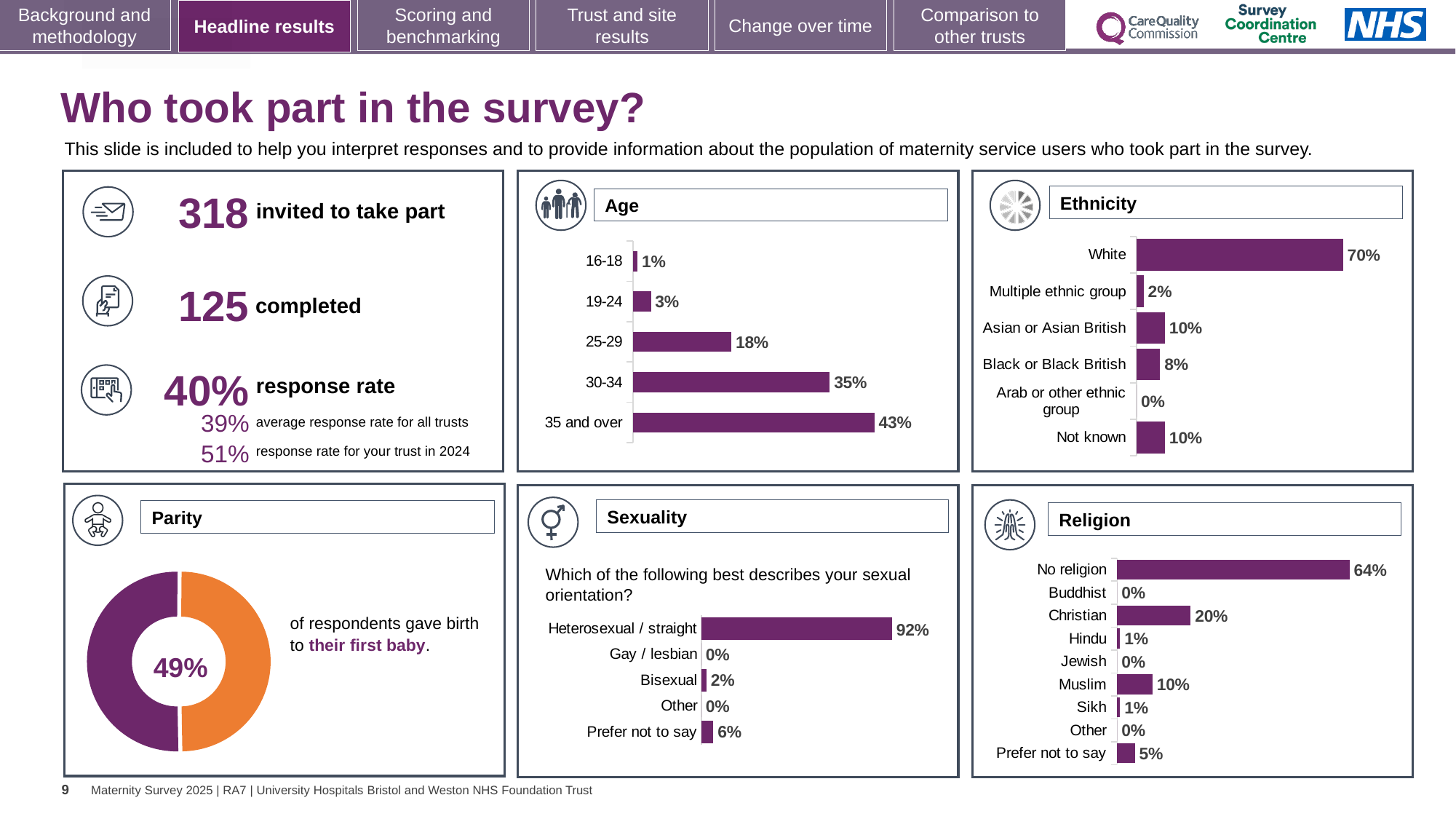
In the Age chart, which age group has the lowest percentage? 16-18 In the Age chart, what percentage of respondents were aged 35 and over? 43% In the Age chart, what is the difference between the 30-34 and 25-29 percentages? 17% In the Religion chart, what percentage of respondents were Christian? 20% In the Ethnicity chart, which is larger: Asian or Asian British or Black or Black British? Asian or Asian British In the Sexuality chart, which category has the highest percentage? Heterosexual / straight What kind of chart is the Parity chart? Doughnut chart In the Ethnicity chart, how many ethnicity categories are shown? 6 In the Ethnicity chart, what percentage of respondents were White? 70% In the Sexuality chart, what percentage of respondents answered Prefer not to say? 6% In the Parity chart, what percentage of respondents gave birth to their first baby? 49% In the Religion chart, what is the difference between No religion and Muslim? 54%